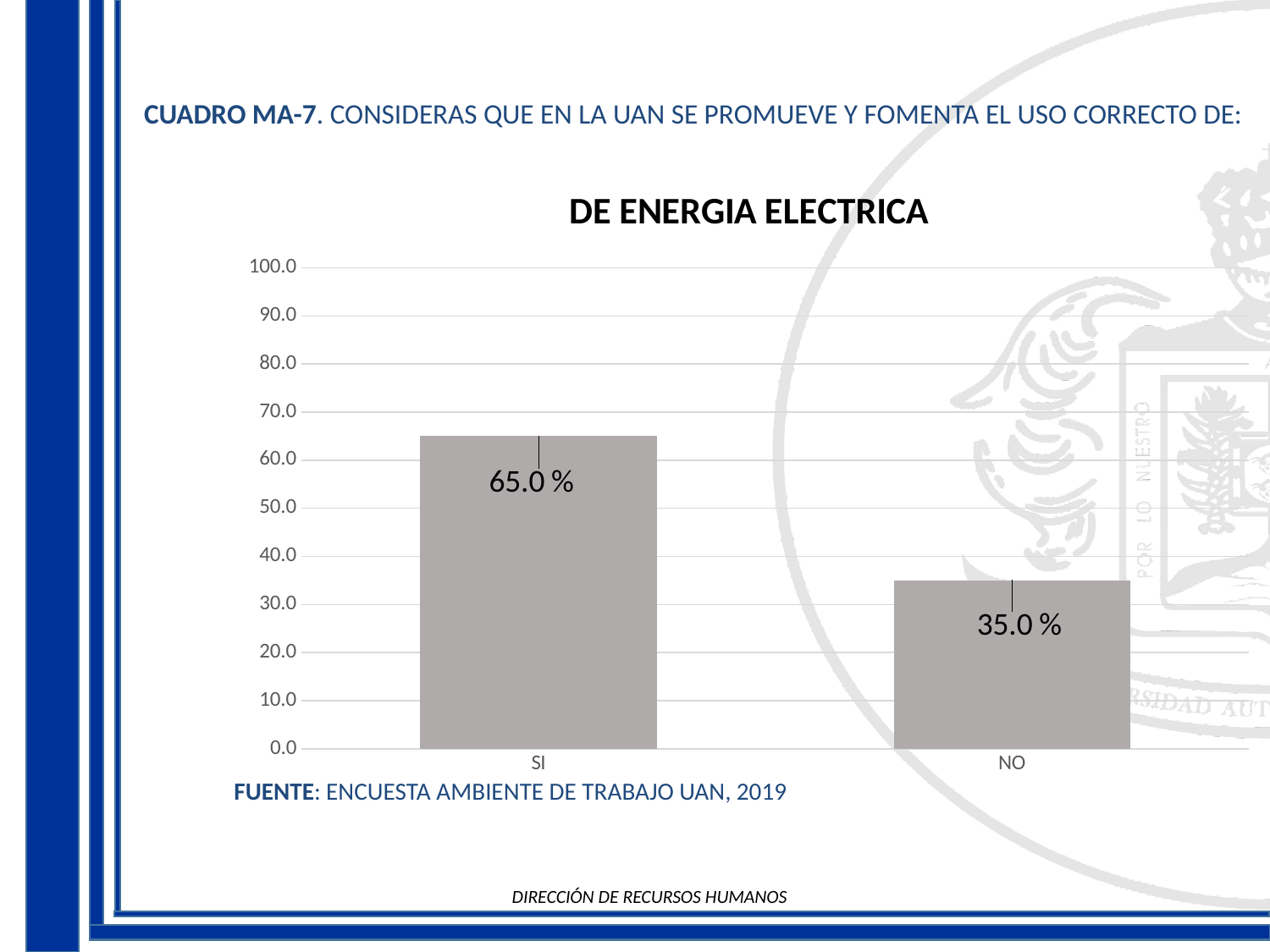
What is the difference between the values for SI and NO? 30.0 % What is the value for SI? 65.0 % Which is larger, the value for SI or the value for NO? SI Which category has the highest value? SI What is the maximum value shown on the y axis? 100.0 Which category has the lowest value? NO What is the value for NO? 35.0 % Is the value for NO greater or less than 40.0? less How many categories are shown on the x axis? 2 What kind of chart is shown? bar chart Is the value for SI greater or less than 60.0? greater What is the title of the chart? DE ENERGIA ELECTRICA